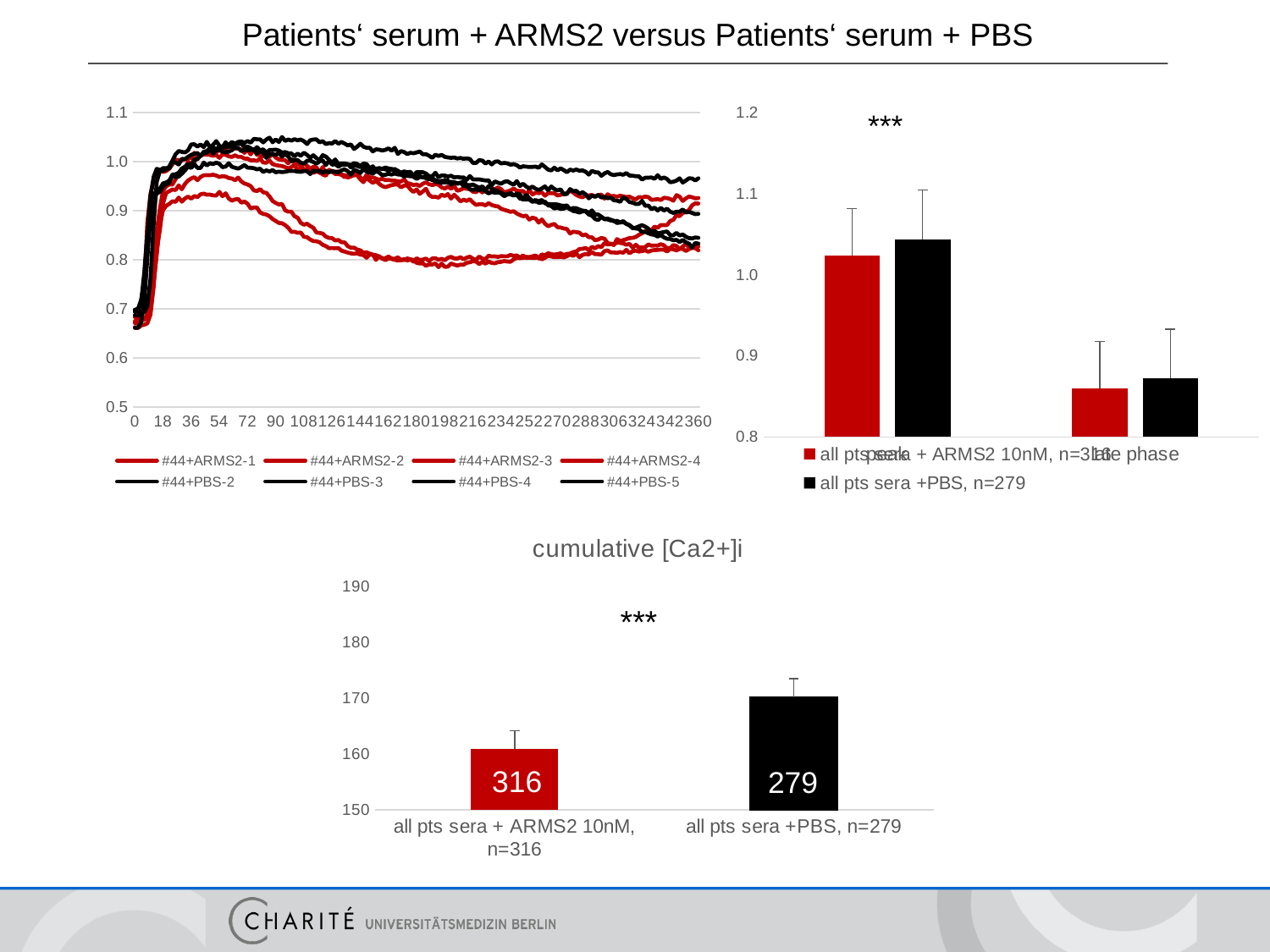
In the bottom chart 'cumulative [Ca2+]i', which bar is higher: 'all pts sera + ARMS2 10nM, n=316' or 'all pts sera +PBS, n=279'? all pts sera +PBS, n=279 What is the title of the bottom chart on the slide? cumulative [Ca2+]i In the top-right bar chart, is the 'late phase' value for 'all pts sera + ARMS2 10nM, n=316' greater or less than 0.9? less In the bottom chart 'cumulative [Ca2+]i', is the value for 'all pts sera + ARMS2 10nM, n=316' greater or less than 170? less What kind of chart is the top-left chart on the slide? line chart How many series does the legend of the top-right bar chart list? 2 How many series does the legend of the top-left line chart list? 8 In the bottom chart 'cumulative [Ca2+]i', how many bars are plotted? 2 In the bottom chart 'cumulative [Ca2+]i', is the value for 'all pts sera +PBS, n=279' greater or less than 160? greater What kind of chart is the bottom chart titled 'cumulative [Ca2+]i'? bar chart In the top-left line chart, what colour are the #44+PBS series drawn in? black